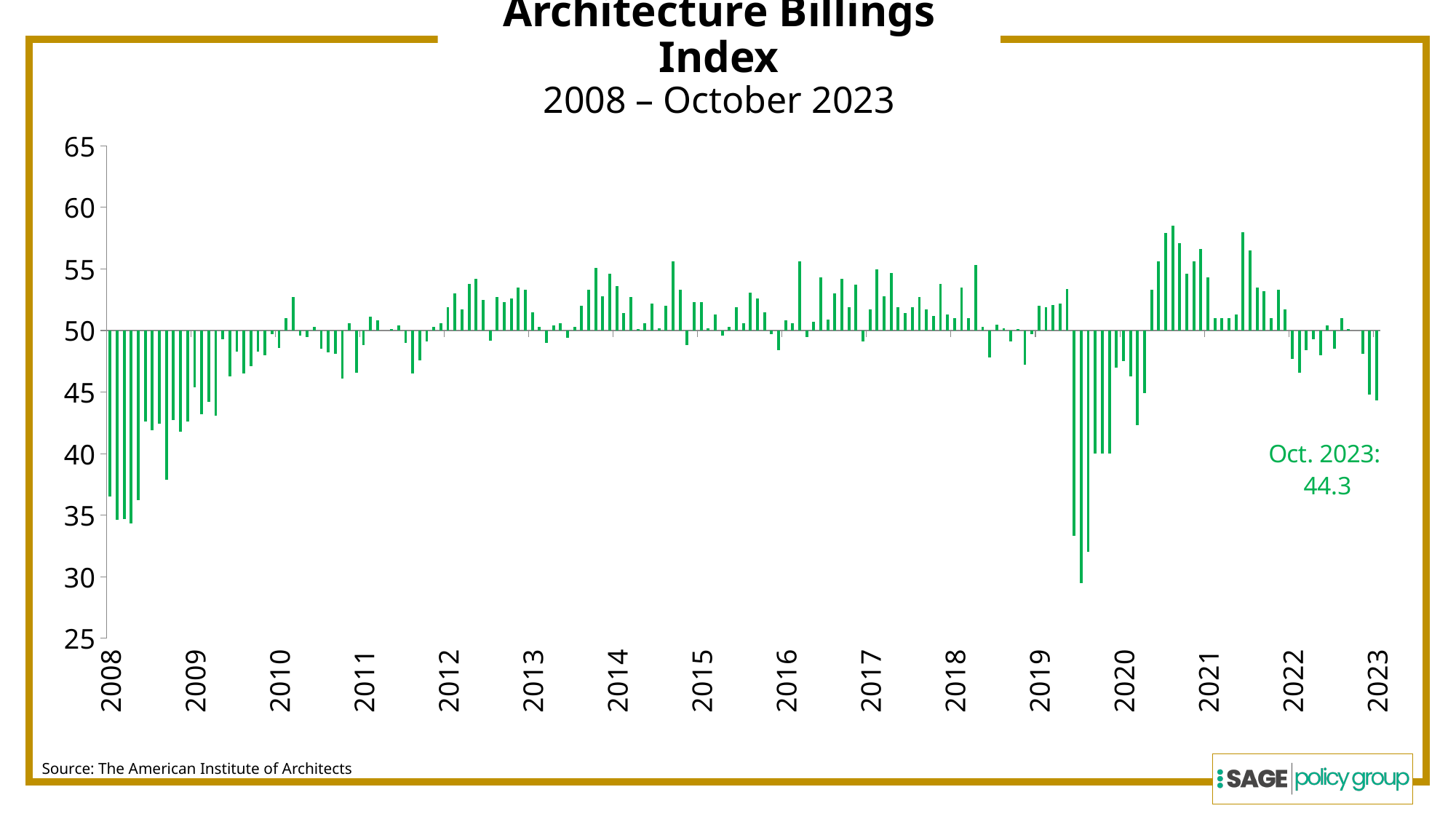
Which is lower: the lowest bar in 2008 or the lowest bar in 2020? 2020 Is the October 2023 value greater or less than 50? less What is the title of the chart? Architecture Billings Index Is the highest value in 2021 greater or less than 55? greater Is the lowest value in 2020 greater or less than 35? less What source is cited for the chart data? The American Institute of Architects In which year does the highest bar on the chart occur? 2021 What kind of chart is used to show the Architecture Billings Index? bar chart Do the values generally rise or fall over the course of 2023? fall In which year does the lowest bar on the chart occur? 2020 What is the value of the Architecture Billings Index for October 2023? 44.3 How many year labels are shown on the x axis? 16